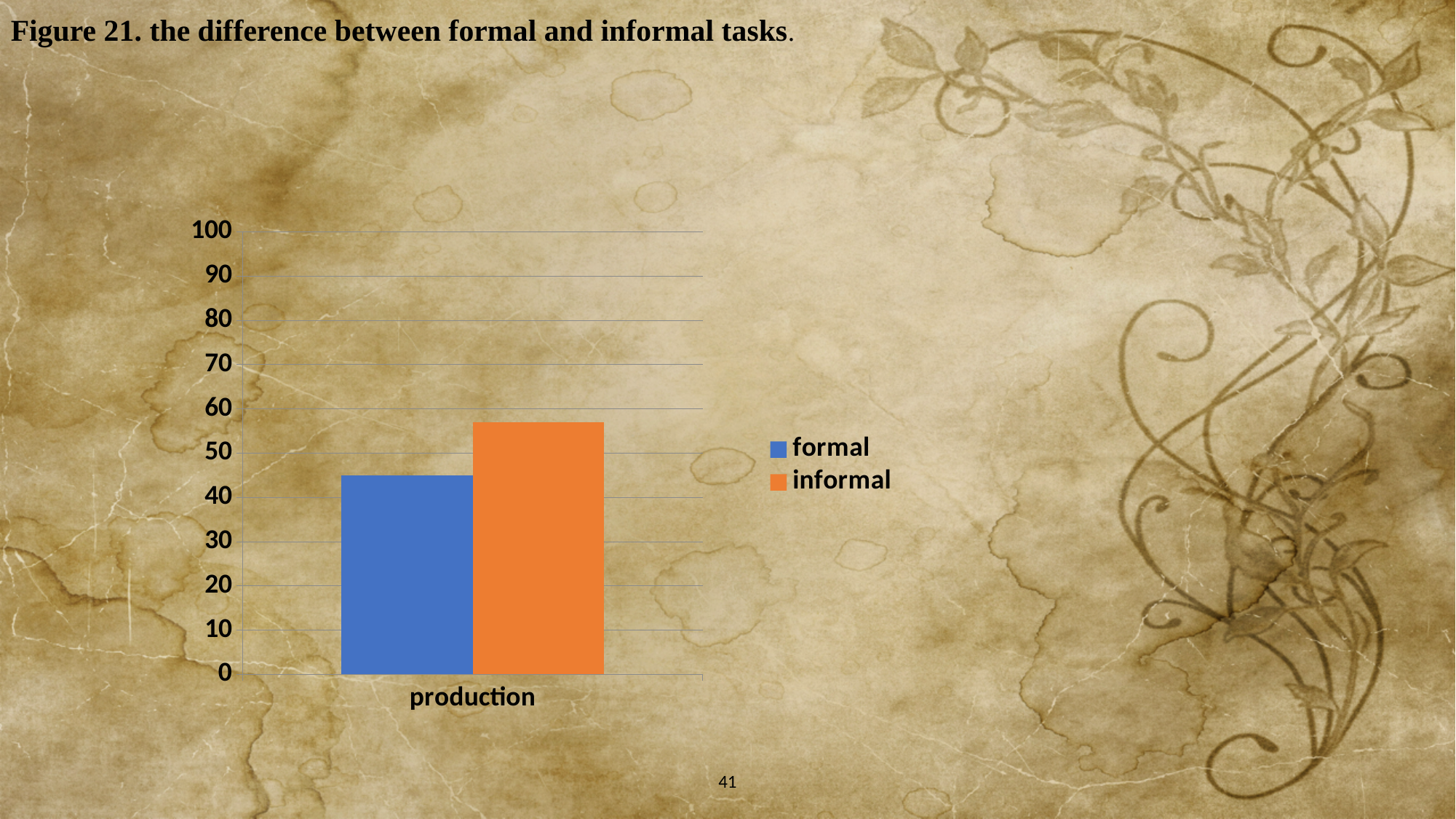
Is the value for formal greater or less than 50? less Which colour represents the informal series in the legend? orange Is the value for informal greater or less than 60? less Which series has the highest bar in the chart? informal Is the value for formal greater or less than 40? greater How many series does the legend list? 2 Which series has the higher value for production, formal or informal? informal What is the label of the category on the x axis? production Which series has the lowest bar in the chart? formal What kind of chart is shown on the slide? bar chart How many categories are shown on the x axis? 1